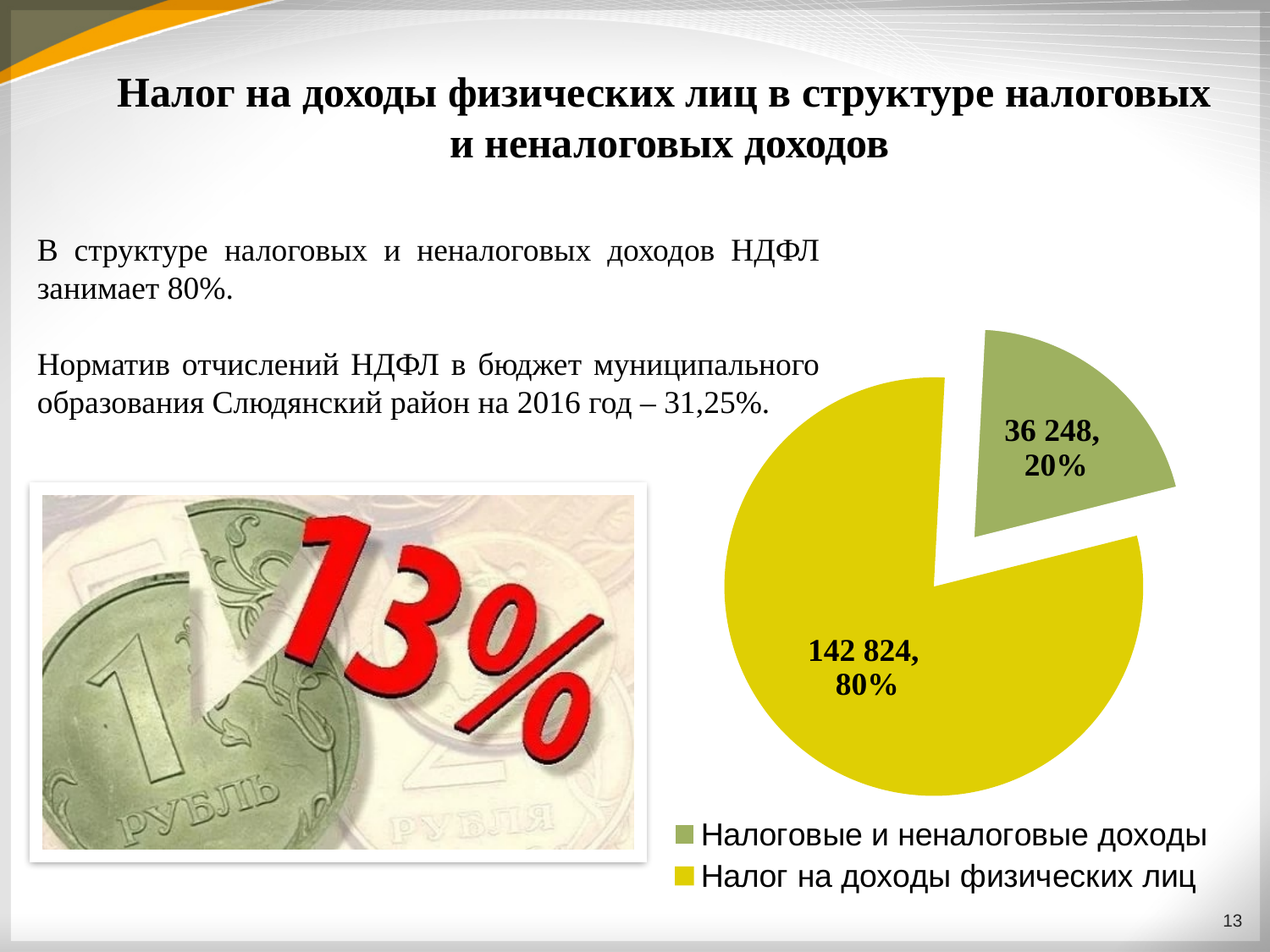
What value is shown for the slice "Налог на доходы физических лиц"? 142 824 What kind of chart is shown on the slide? Pie chart What share of the pie does "Налог на доходы физических лиц" take? 80% How many slices does the pie chart have? 2 What share of the pie does "Налоговые и неналоговые доходы" take? 20% Which slice of the pie is the largest? Налог на доходы физических лиц What value is shown for the slice "Налоговые и неналоговые доходы"? 36 248 What is the difference between the values of the two slices, 142 824 and 36 248? 106 576 Which is larger: the value for "Налог на доходы физических лиц" or the value for "Налоговые и неналоговые доходы"? Налог на доходы физических лиц Which slice of the pie is the smallest? Налоговые и неналоговые доходы How many entries does the chart legend list? 2 What colour is the slice for "Налог на доходы физических лиц"? Yellow